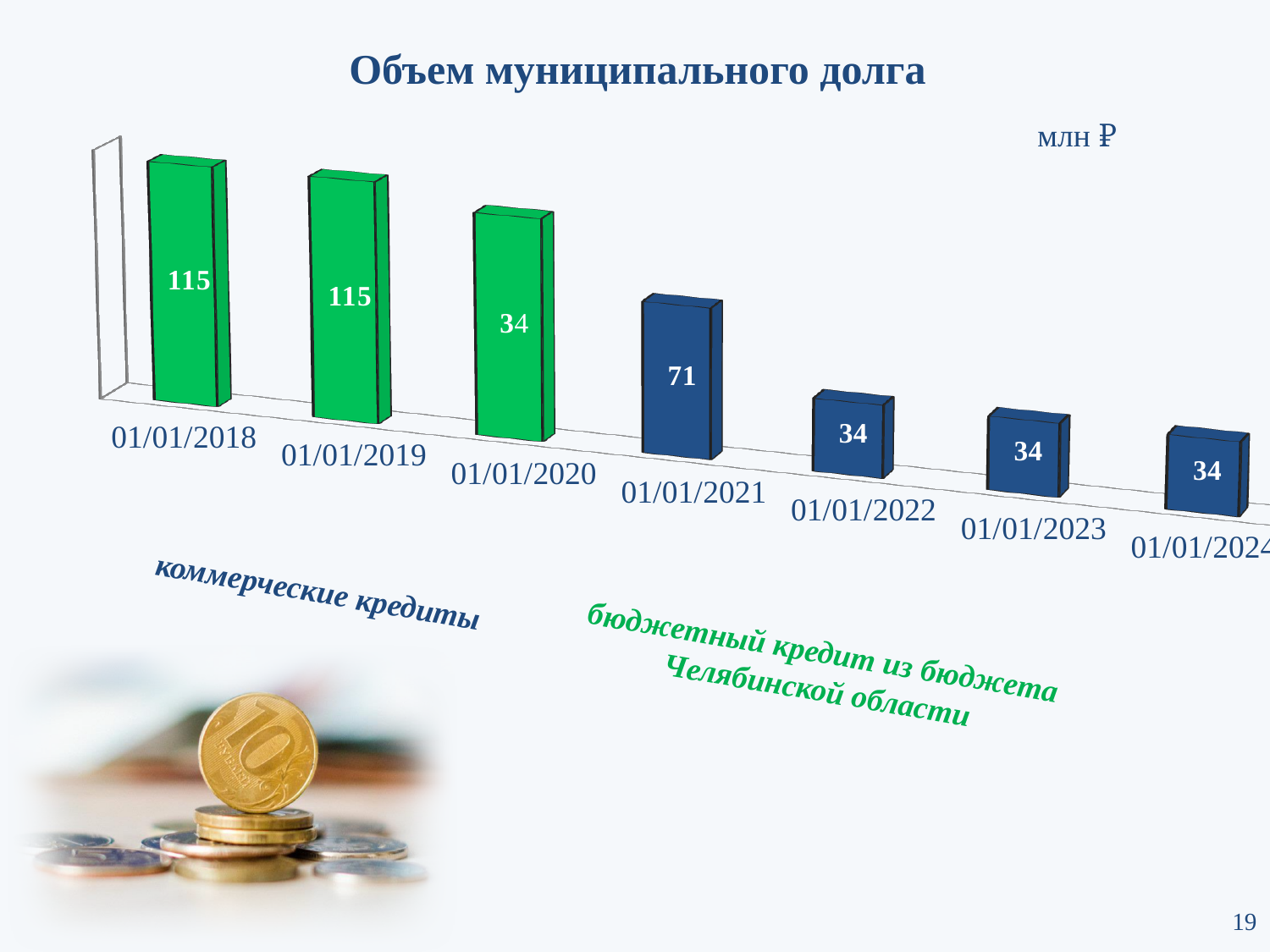
What is the difference between the values for 01/01/2021 and 01/01/2022? 37 What is the value for 01/01/2018? 115 What kind of chart is shown on the slide? bar chart What is the difference between the values for 01/01/2018 and 01/01/2021? 44 What is the value for 01/01/2024? 34 What is the title of the chart? Объем муниципального долга What is the value for 01/01/2022? 34 What value is labelled on the bar for 01/01/2021? 71 Which is larger, the value for 01/01/2019 or the value for 01/01/2021? 01/01/2019 What is the value for 01/01/2019? 115 Do the values generally rise or fall from 01/01/2018 to 01/01/2024? fall How many dates are shown on the x axis of the chart? 7